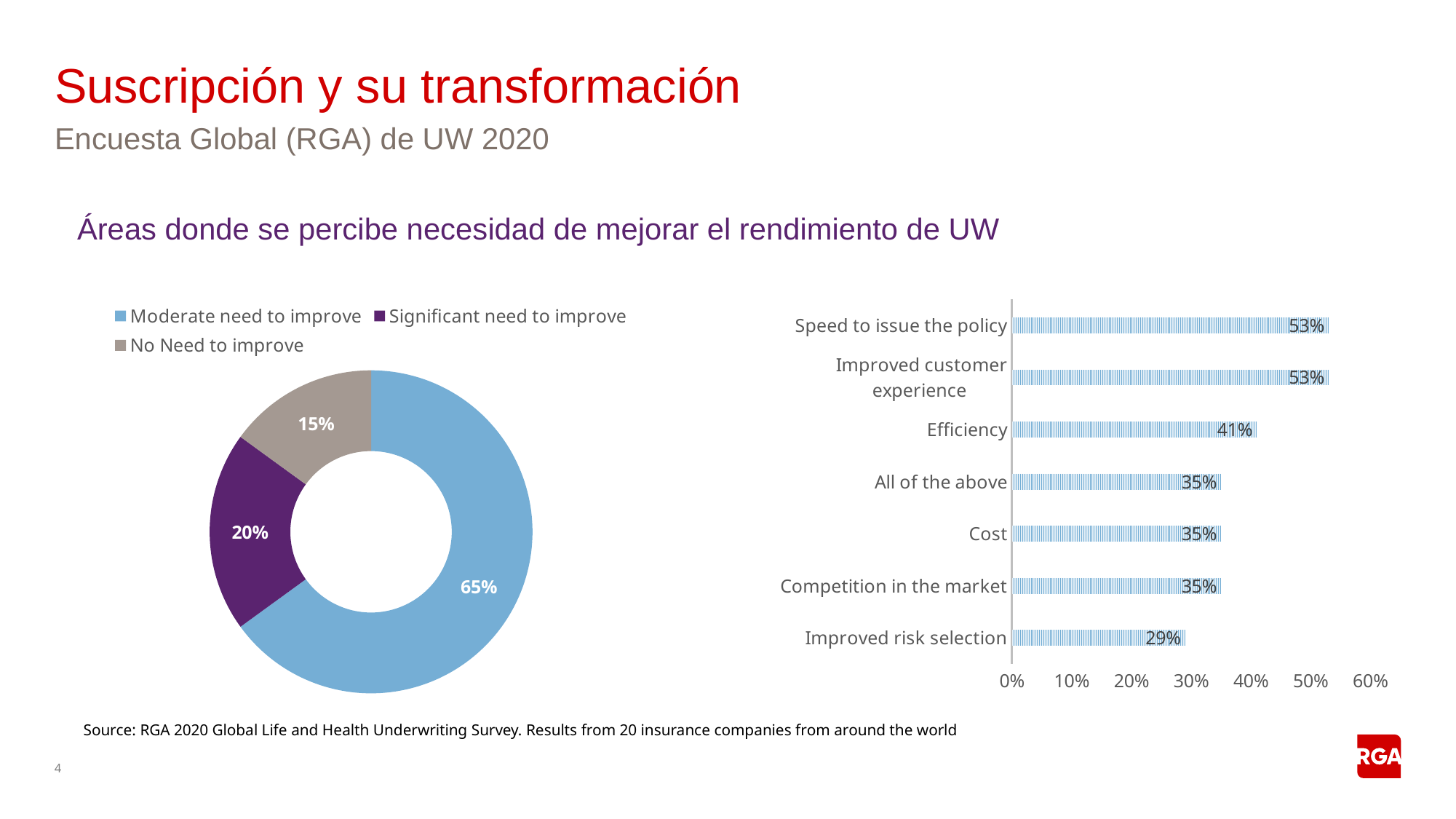
In the doughnut chart on the left, what share is labelled for 'No Need to improve'? 15% In the bar chart on the right, what is the value for 'Cost'? 35% In the bar chart on the right, what is the difference between 'Speed to issue the policy' and 'Efficiency'? 12% In the bar chart on the right, how many categories are plotted? 7 In the doughnut chart on the left, which category has the largest share? Moderate need to improve In the doughnut chart on the left, what share is labelled for 'Moderate need to improve'? 65% In the bar chart on the right, what is the value for 'Improved risk selection'? 29% In the bar chart on the right, which category has the lowest value? Improved risk selection In the bar chart on the right, what is the value for 'Efficiency'? 41% What kind of chart is shown on the right side of the slide? Bar chart In the doughnut chart on the left, what share is labelled for 'Significant need to improve'? 20% In the doughnut chart on the left, how many categories does the legend list? 3